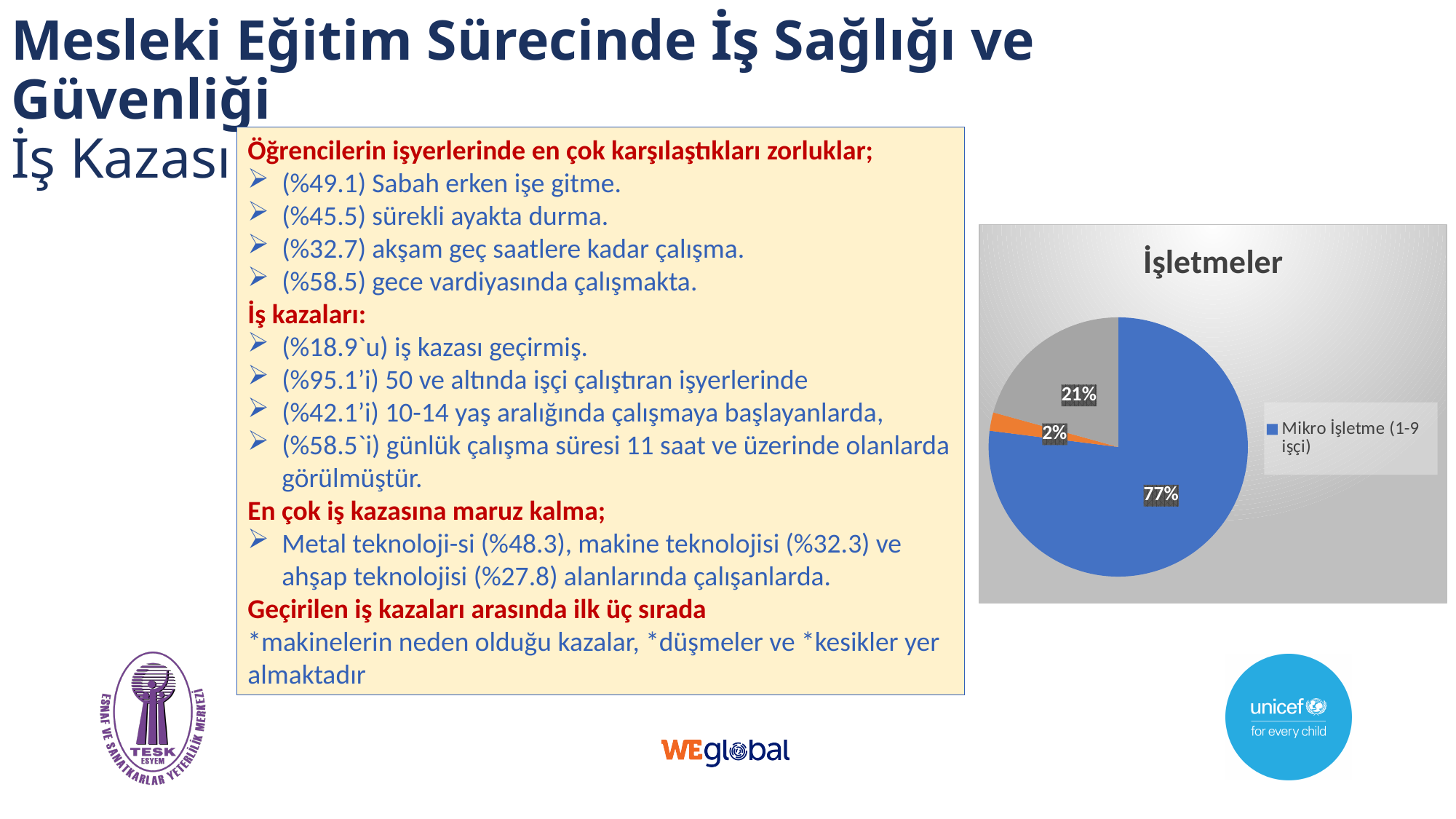
Is the share for Mikro İşletme (1-9 işçi) greater or less than 50%? greater What kind of chart is shown on the slide? pie chart What is the value shown on the grey slice of the pie chart? 21% What colour is the Mikro İşletme (1-9 işçi) slice? blue What share of the pie does Mikro İşletme (1-9 işçi) have? 77% What is the difference between the Mikro İşletme (1-9 işçi) slice and the grey slice? 56 percentage points What do the three slice percentages in the pie chart add up to? 100% Is the grey slice larger or smaller than the orange slice? larger How many slices does the İşletmeler pie chart have? 3 What is the value of the smallest slice in the pie chart? 2% Which category has the largest slice in the İşletmeler pie chart? Mikro İşletme (1-9 işçi) What is the title of the pie chart? İşletmeler